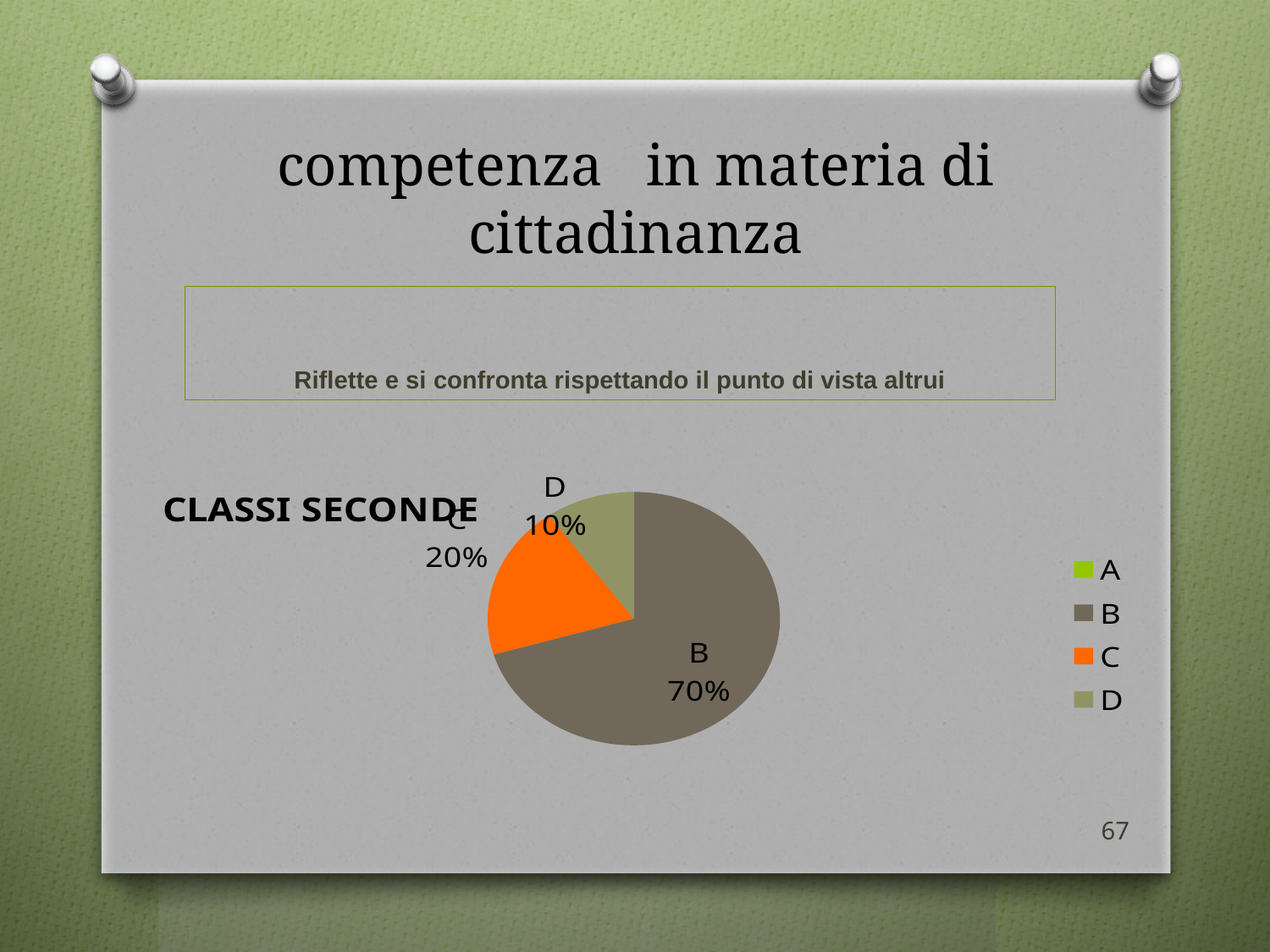
What percentage does slice C represent in the pie chart? 20% What percentage does slice B represent in the pie chart? 70% How many entries does the legend list? 4 How many slices with data labels are visible in the pie chart? 3 What kind of chart is shown on the slide? pie chart Which is larger, the share for C or the share for D? C What percentage does slice D represent in the pie chart? 10% What colour is the slice for category C? orange What is the title of the chart? CLASSI SECONDE Which category has the largest slice of the pie? B What is the difference in percentage points between slice B and slice C? 50 Of the slices with visible labels, which category has the smallest share? D